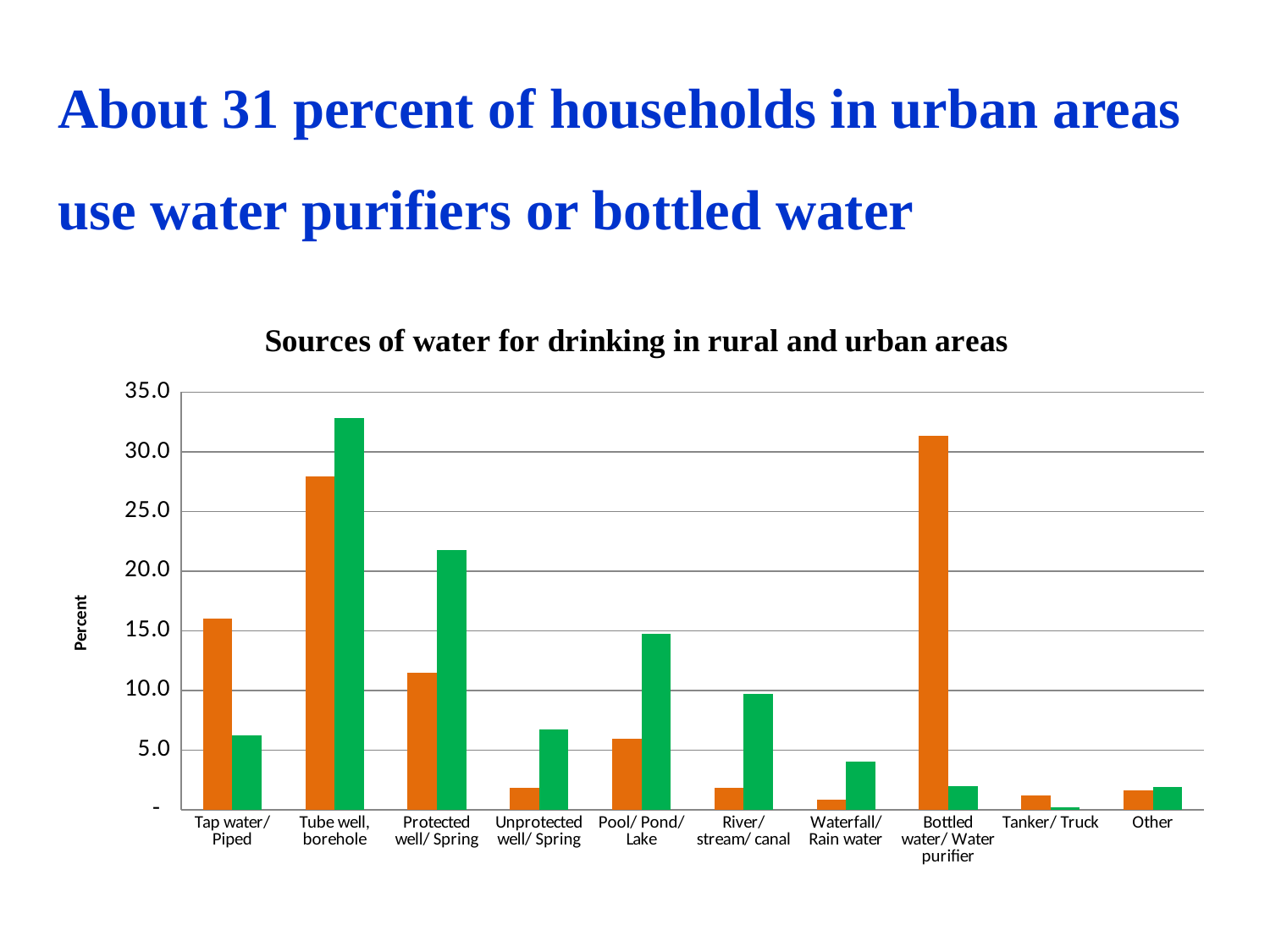
What kind of chart is shown on the slide? bar chart Which category has the tallest green bar? Tube well, borehole Is the orange bar for Protected well/ Spring greater or less than 10.0? greater What is the title of the chart? Sources of water for drinking in rural and urban areas For Pool/ Pond/ Lake, which bar is taller, the orange or the green? green How many water source categories are shown on the x axis? 10 Is the green bar for Protected well/ Spring greater or less than 20.0? greater Which category has the shortest green bar? Tanker/ Truck Is the orange bar for Bottled water/ Water purifier greater or less than 30.0? greater For Tap water/ Piped, which bar is taller, the orange or the green? orange Which category has the tallest orange bar? Bottled water/ Water purifier